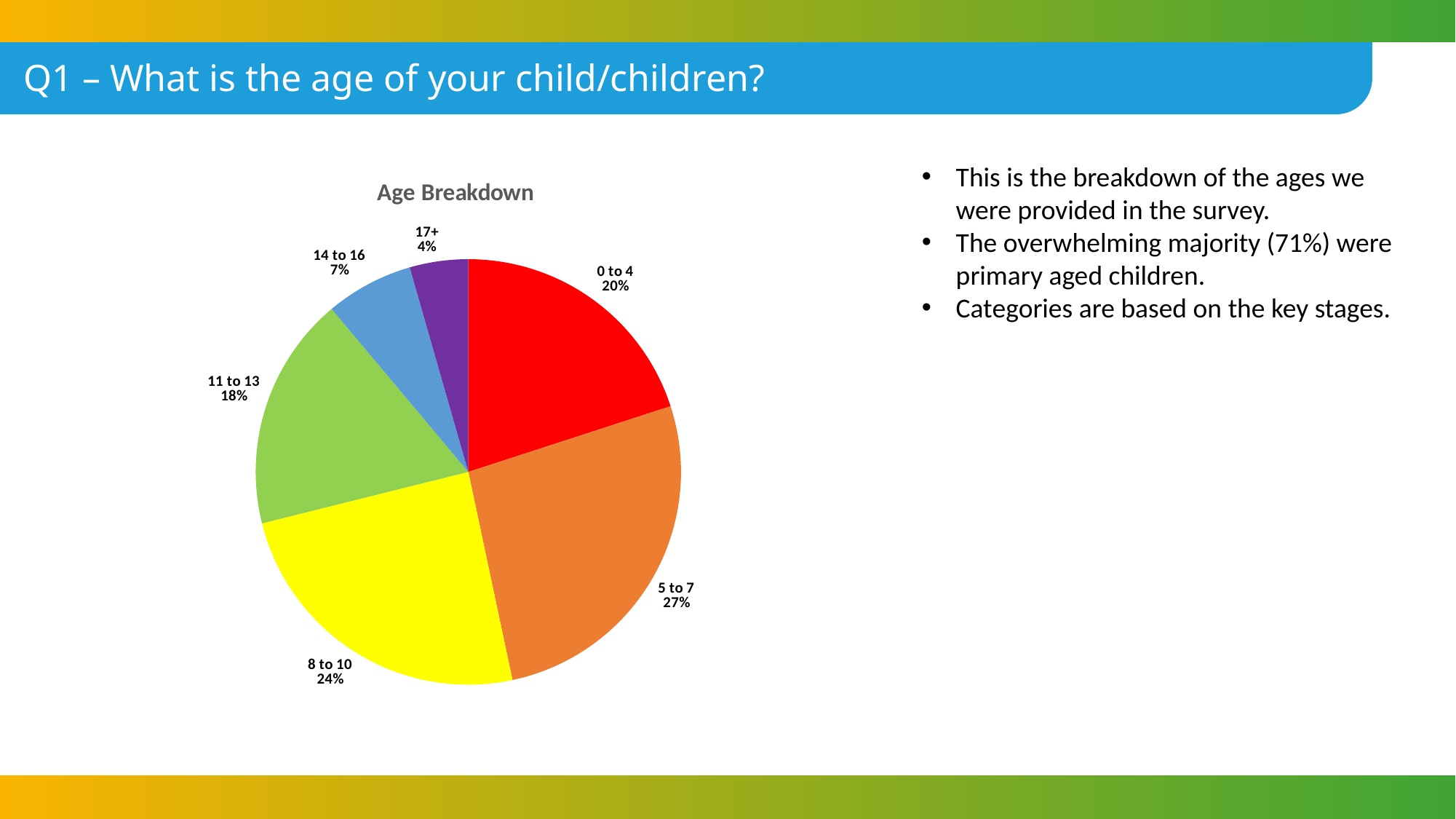
How many age categories are shown in the pie chart? 6 What share of the pie is the 5 to 7 age group? 27% Which is larger, the share for 14 to 16 or the share for 11 to 13? 11 to 13 Which age group has the smallest share of the pie? 17+ What type of chart is shown on the slide? pie chart What percentage is shown for the 17+ age group? 4% What colour is the slice for the 8 to 10 age group? yellow What is the difference in percentage points between the 8 to 10 and 11 to 13 age groups? 6 Which age group has the largest share of the pie? 5 to 7 What is the combined percentage of the 0 to 4 and 5 to 7 age groups? 47% What percentage is shown for the 0 to 4 age group? 20% What is the title of the chart? Age Breakdown